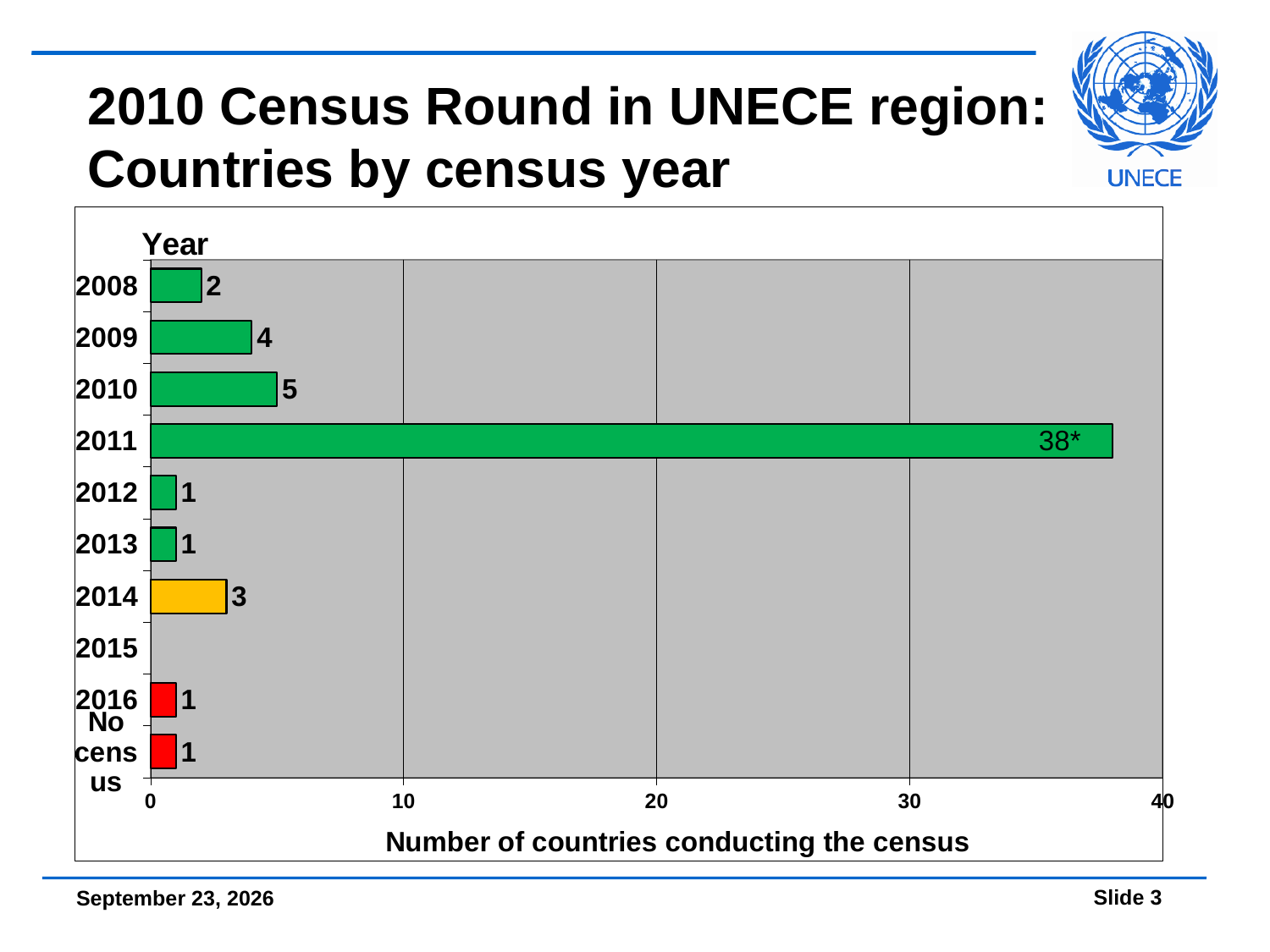
How many categories are listed on the vertical axis of the chart? 10 What kind of chart is shown on the slide? bar chart Which has a larger value, 2009 or 2014? 2009 How many countries conducted the census in 2014? 3 What is the value shown for 2011? 38* Which year has the highest number of countries conducting the census? 2011 What is the difference between the values for 2010 and 2008? 3 What is the label of the horizontal axis? Number of countries conducting the census Is the value for 2011 greater or less than 30? greater What colour are the bars for 2016 and 'No census'? red How many countries conducted the census in 2010? 5 What is the value shown for the 'No census' category? 1